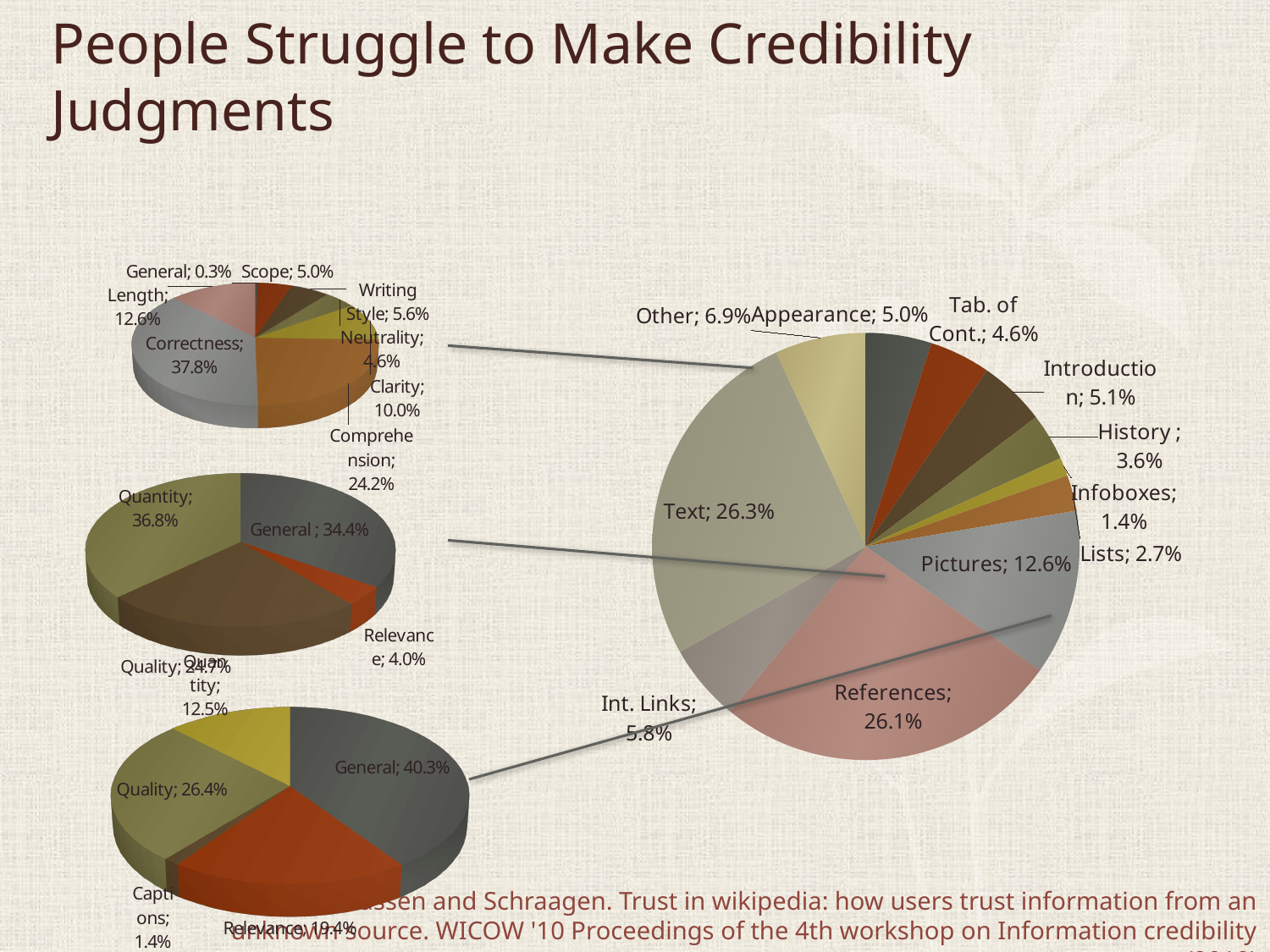
In the top-left pie chart, which category has the largest share? Correctness In the large pie chart on the right, what is the difference between the Pictures share and the Other share? 5.7% In the middle-left pie chart, which category has the largest share? Quantity In the top-left pie chart, what is the value for Correctness? 37.8% In the large pie chart on the right, what is the value for Text? 26.3% In the large pie chart on the right, which is larger, Introduction or History? Introduction In the large pie chart on the right, what is the value for References? 26.1% In the large pie chart on the right, what is the value for Pictures? 12.6% In the bottom-left pie chart, what is the value for General? 40.3% What kind of chart is the large chart on the right of the slide? Pie chart In the top-left pie chart, what is the value for Comprehension? 24.2% In the large pie chart on the right, which category has the smallest share? Infoboxes